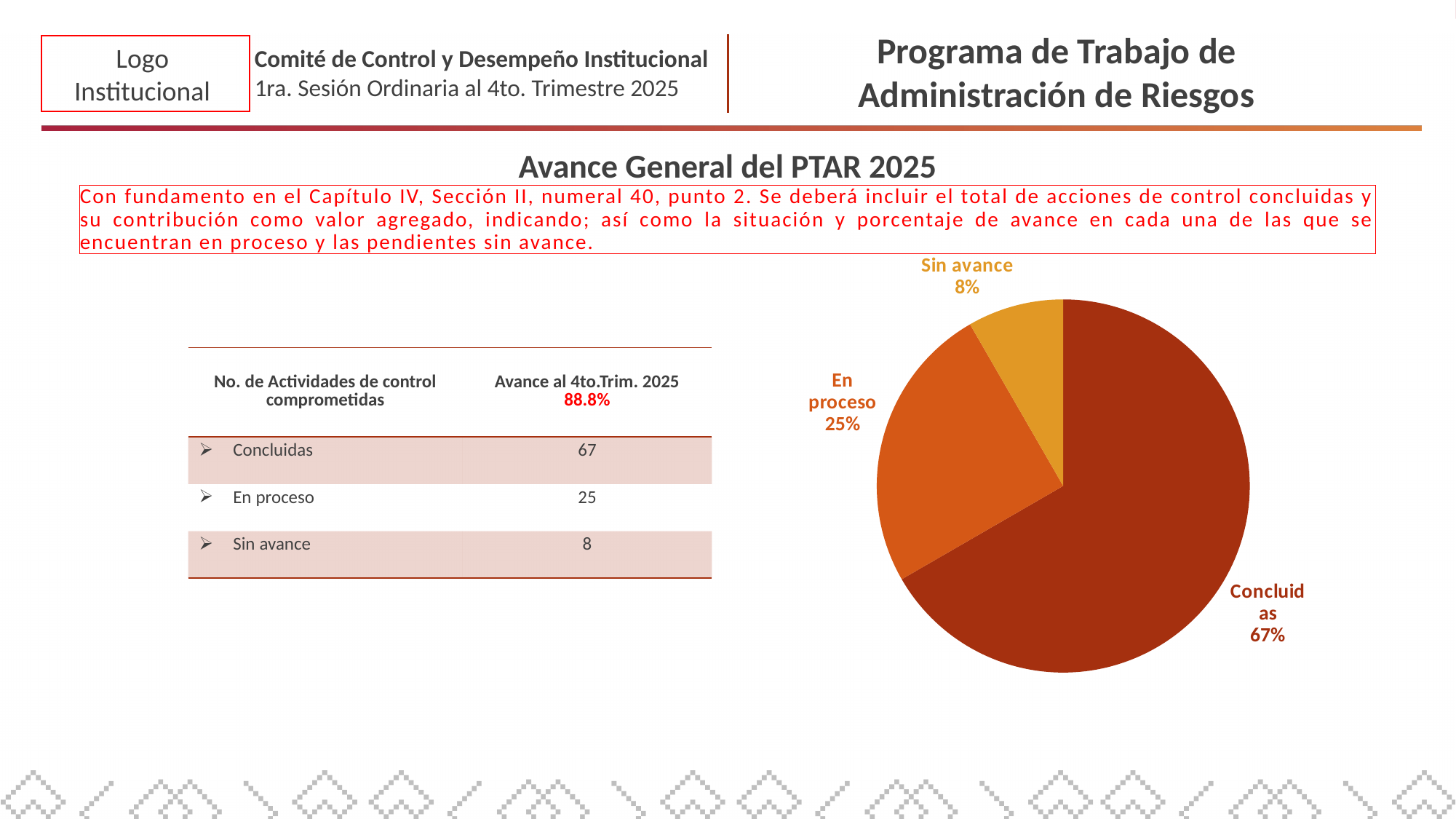
What colour is the Sin avance slice in the pie chart? yellow-orange Which slice of the pie chart is the smallest? Sin avance What share of the pie does the Concluidas slice represent? 67% What share of the pie does the En proceso slice represent? 25% How many slices does the pie chart have? 3 What kind of chart is shown on the slide? pie chart Which slice of the pie chart is the largest? Concluidas Which is larger in the pie chart, En proceso or Sin avance? En proceso What is the difference in percentage points between the Concluidas and En proceso slices? 42 Is the share of the Concluidas slice greater or less than 50%? greater What is the difference in percentage points between the En proceso and Sin avance slices? 17 What share of the pie does the Sin avance slice represent? 8%